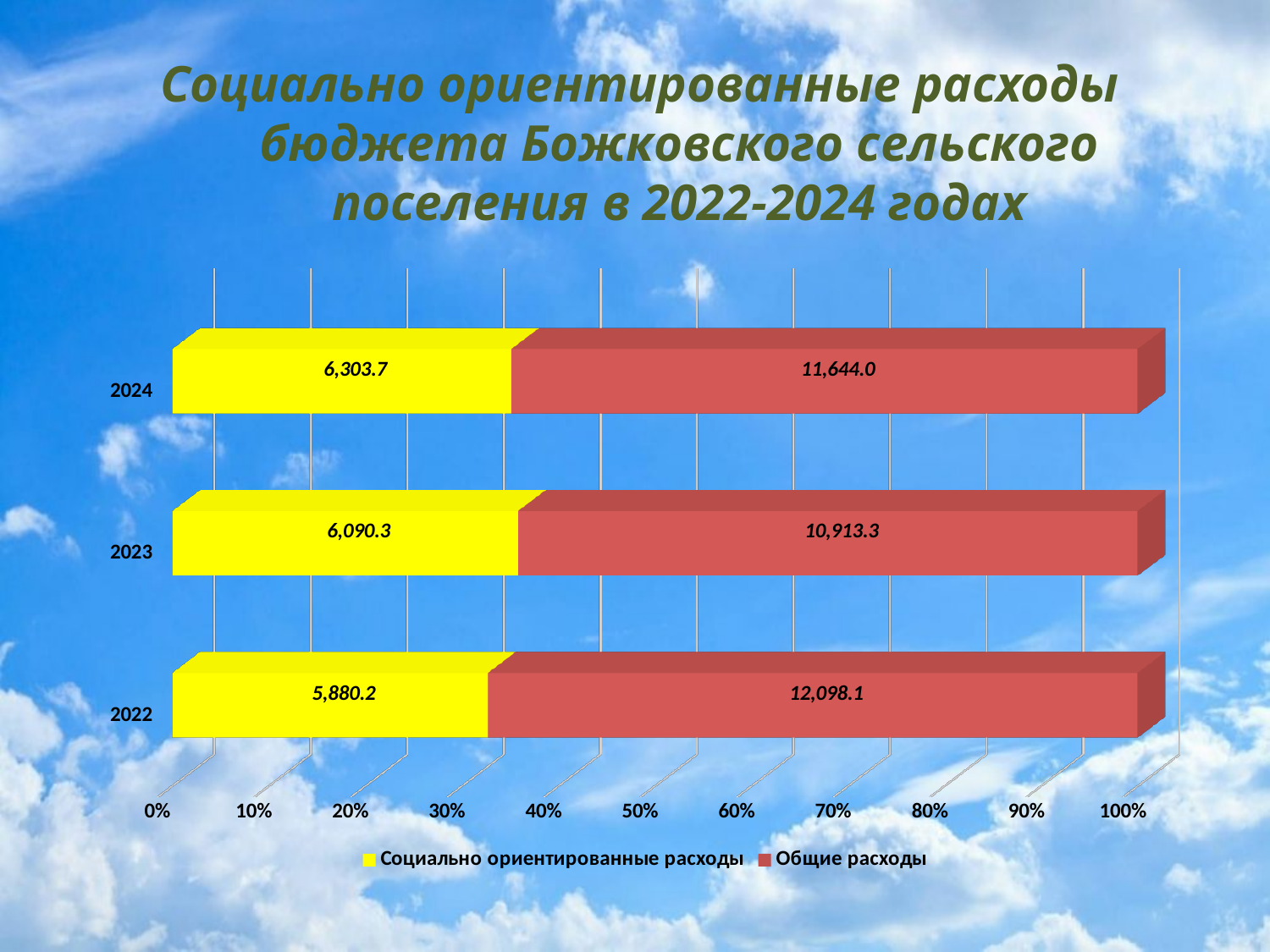
Which year has the lowest value for Общие расходы? 2023 What is the value of Социально ориентированные расходы for 2024? 6,303.7 What is the value of Общие расходы for 2023? 10,913.3 What is the value of Социально ориентированные расходы for 2022? 5,880.2 How many years are shown on the chart? 3 What is the value of Общие расходы for 2022? 12,098.1 Which year has the highest value for Социально ориентированные расходы? 2024 Which is larger: Общие расходы for 2024 or for 2023? 2024 (11,644.0) How many series does the legend list? 2 What is the difference between the Социально ориентированные расходы values for 2024 and 2023? 213.4 Which colour represents Общие расходы in the legend? Red What kind of chart is shown on the slide? Stacked bar chart